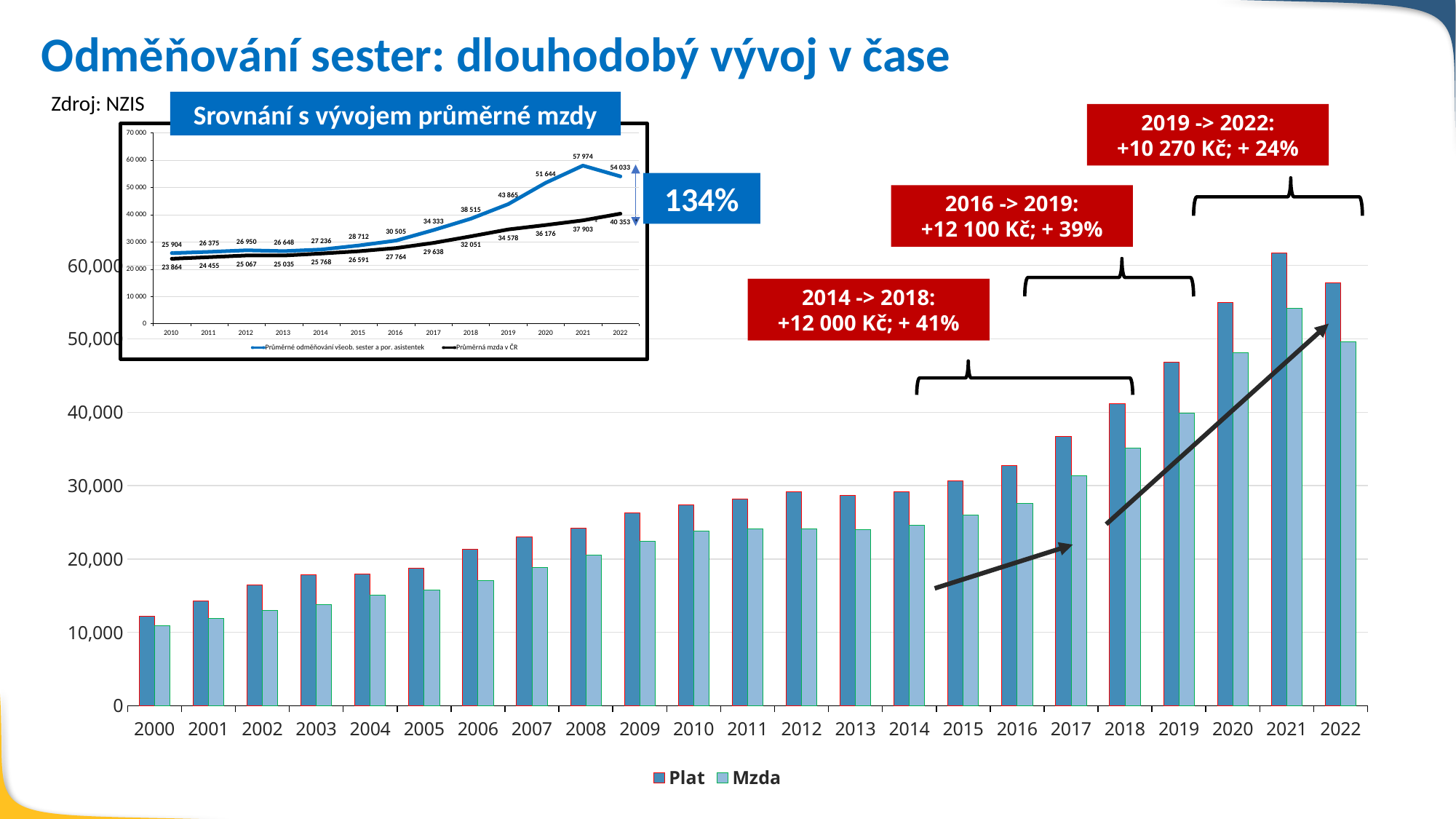
In the large bar chart at the bottom, how many years are shown on the x axis? 23 What kind of chart is the inset chart titled 'Srovnání s vývojem průměrné mzdy'? line chart In the large bar chart at the bottom, which is larger in 2018, Plat or Mzda? Plat In the inset chart 'Srovnání s vývojem průměrné mzdy', what is the difference between the blue line and the black line in 2019? 9 287 In the large bar chart at the bottom, is the Plat value for 2022 greater or less than 50,000? greater In the large bar chart at the bottom, is the Plat value for 2019 greater or less than 40,000? greater In the large bar chart at the bottom, do the Plat values generally rise or fall from 2000 to 2021? rise In the large bar chart at the bottom, how many series does the legend list? 2 In the inset chart 'Srovnání s vývojem průměrné mzdy', what is the value of the blue line (Průměrné odměňování všeob. sester a por. asistentek) in 2021? 57 974 In the large bar chart at the bottom, which year has the highest Plat value? 2021 In the inset chart 'Srovnání s vývojem průměrné mzdy', what is the value of the black line (Průměrná mzda v ČR) in 2022? 40 353 In the large bar chart at the bottom, which year has the lowest Mzda value? 2000